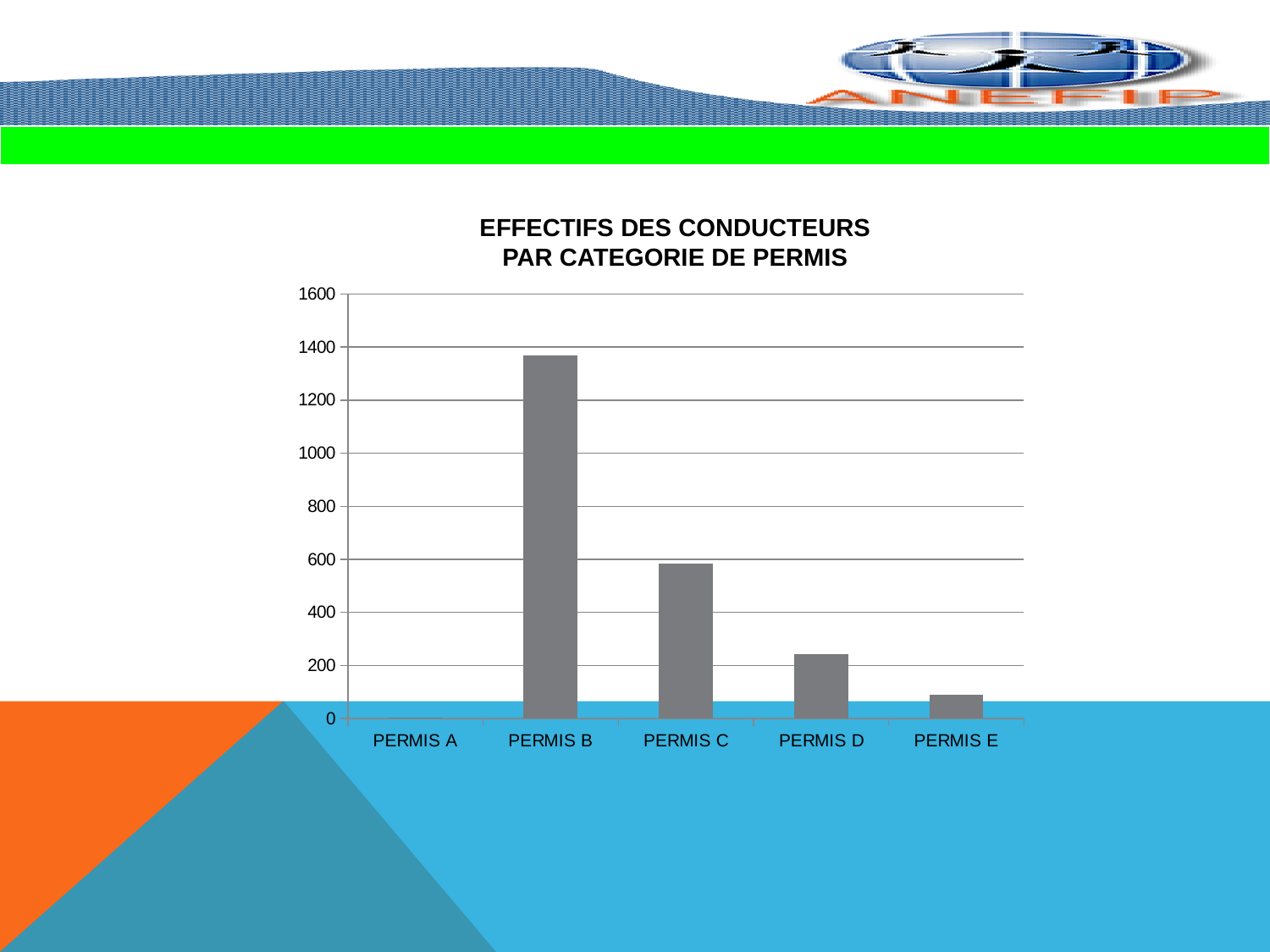
What kind of chart is shown on the slide? bar chart Is the value for PERMIS E greater or less than 200? less Is the value for PERMIS B greater or less than 1400? less Is the value for PERMIS C greater or less than 400? greater What is the title of the chart? EFFECTIFS DES CONDUCTEURS PAR CATEGORIE DE PERMIS Which licence category has the lowest number of drivers? PERMIS A From PERMIS B to PERMIS E, do the values rise or fall along the x axis? fall Which licence category has the highest number of drivers? PERMIS B How many licence categories are shown on the x axis? 5 Which has more drivers, PERMIS C or PERMIS D? PERMIS C